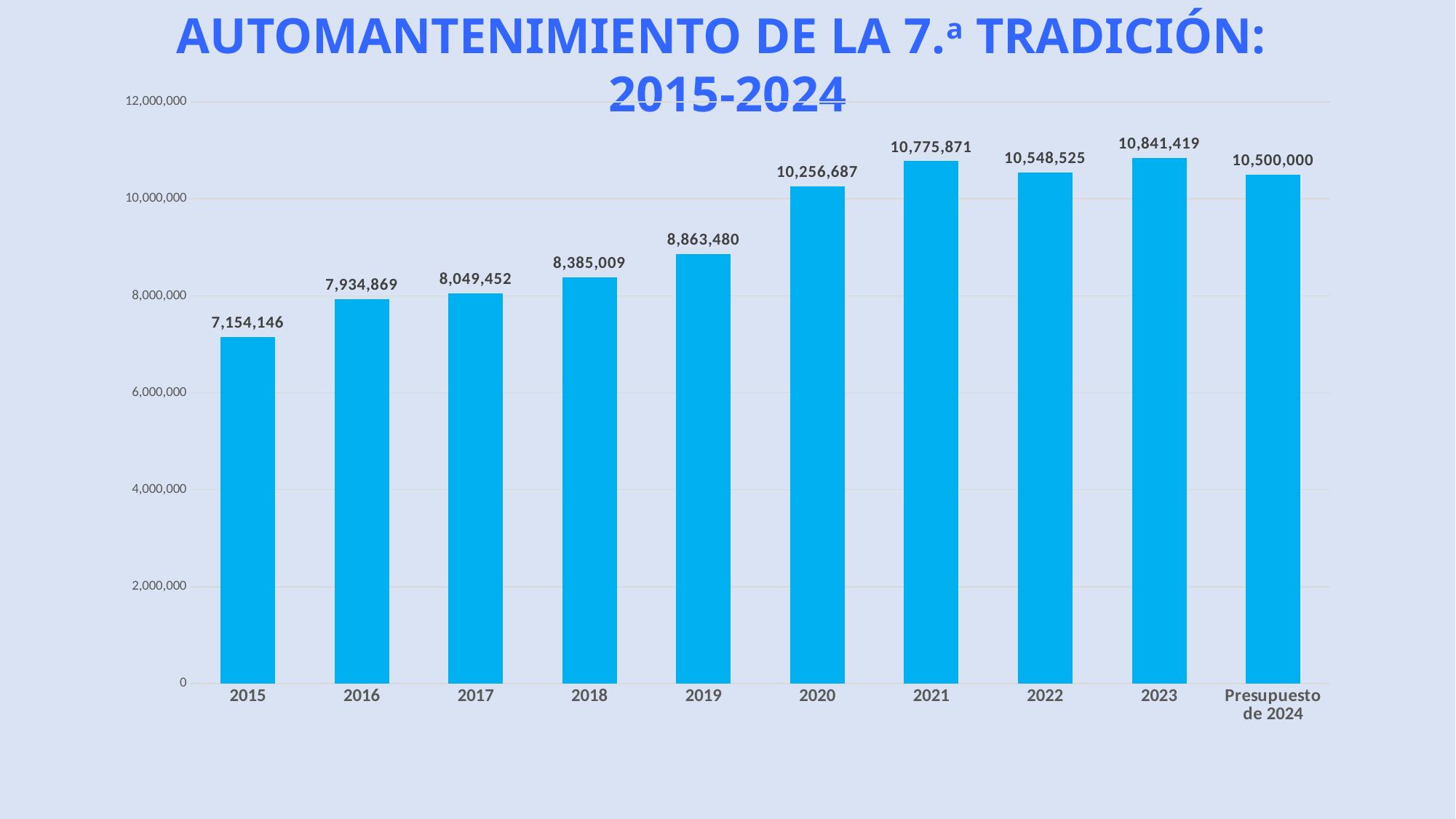
Which category has the highest value? 2023 What is the title of the chart? AUTOMANTENIMIENTO DE LA 7.ª TRADICIÓN: 2015-2024 How many categories are shown on the x axis? 10 Is the value for 2019 greater or less than 10,000,000? less What is the value for 2020? 10,256,687 What is the value for Presupuesto de 2024? 10,500,000 What kind of chart is shown on the slide? bar chart What is the difference between the values for 2023 and 2015? 3,687,273 What is the value for 2015? 7,154,146 Which category has the lowest value? 2015 Which is larger, the value for 2022 or the value for Presupuesto de 2024? 2022 What is the difference between the values for 2021 and 2020? 519,184